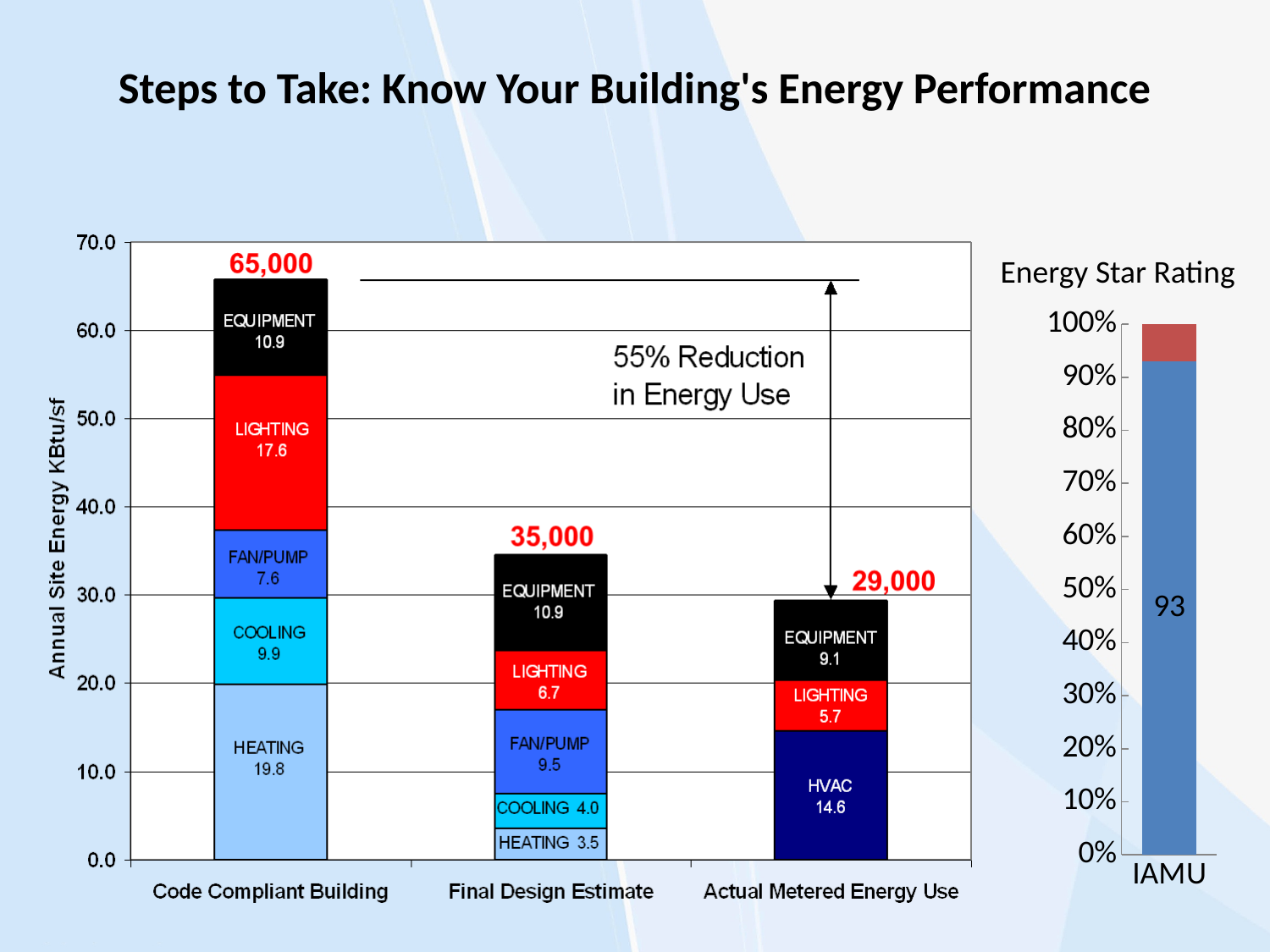
What kind of chart is the left chart with the Annual Site Energy axis? Stacked bar chart In the left stacked bar chart, which category has the tallest bar? Code Compliant Building In the left stacked bar chart, what is the HVAC value for Actual Metered Energy Use? 14.6 In the Energy Star Rating chart, what value is printed on the IAMU bar? 93 In the left stacked bar chart, what red figure is printed above the Code Compliant Building bar? 65,000 How many categories are shown on the x axis of the left stacked bar chart? 3 In the left stacked bar chart, which has the larger FAN/PUMP value: Code Compliant Building or Final Design Estimate? Final Design Estimate In the left stacked bar chart, what percentage reduction in energy use is annotated between the bars? 55% In the left stacked bar chart, what is the HEATING value for the Code Compliant Building? 19.8 In the left stacked bar chart, what is the LIGHTING value for the Final Design Estimate? 6.7 In the left stacked bar chart, what is the difference between the EQUIPMENT value for the Code Compliant Building and the EQUIPMENT value for Actual Metered Energy Use? 1.8 In the left stacked bar chart, what is the total of the labelled segments in the Actual Metered Energy Use bar? 29.4